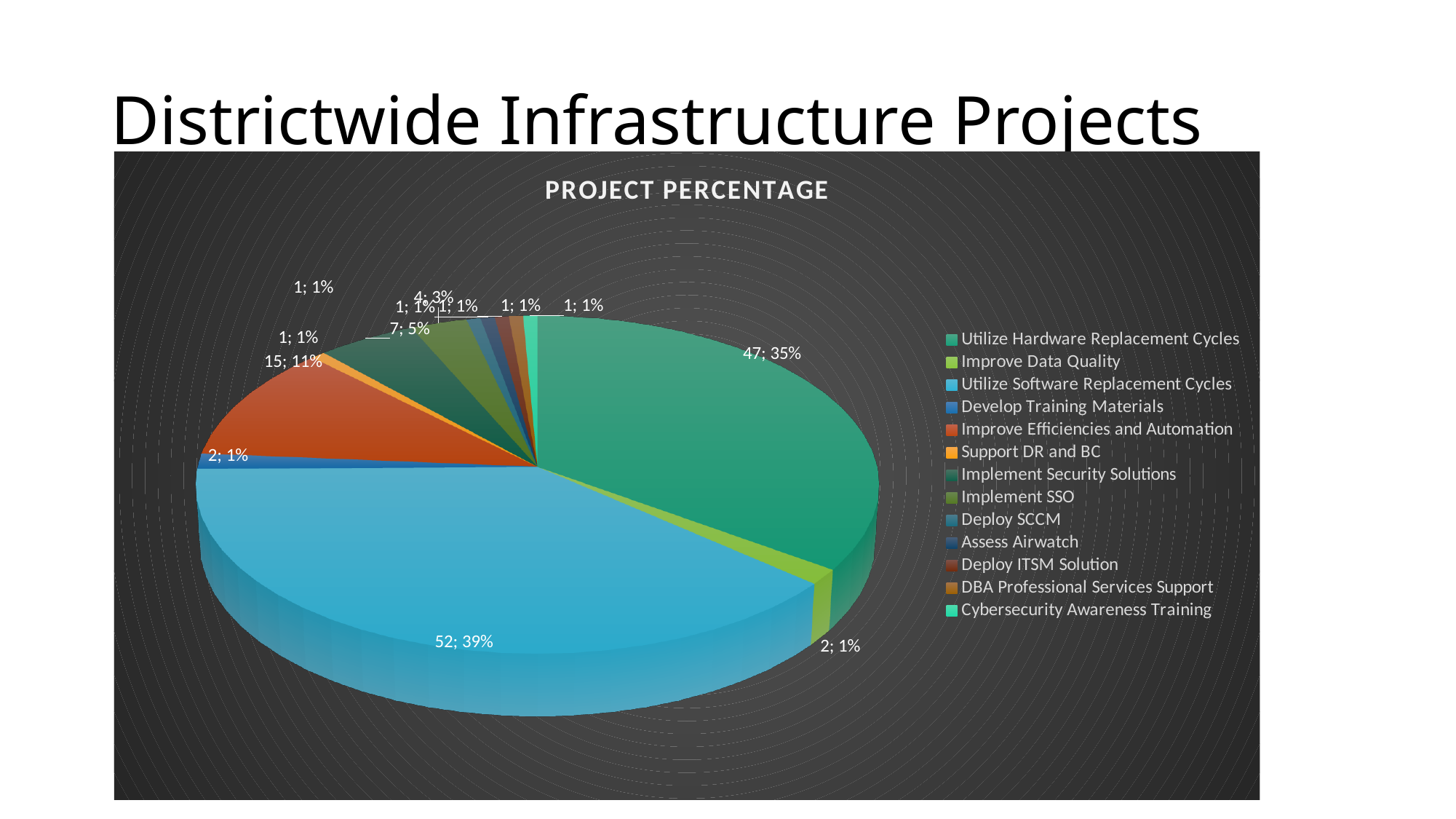
What is the difference between the value for Utilize Software Replacement Cycles and the value for Utilize Hardware Replacement Cycles? 5 How many categories does the legend of the pie chart list? 13 What is the value shown for Improve Efficiencies and Automation? 15 What share of the pie does Improve Efficiencies and Automation represent? 11% What share of the pie does Utilize Software Replacement Cycles represent? 39% Which is larger, the value for Utilize Software Replacement Cycles or the value for Utilize Hardware Replacement Cycles? Utilize Software Replacement Cycles What share of the pie does Utilize Hardware Replacement Cycles represent? 35% What is the value shown for Implement Security Solutions? 7 What is the title of the chart? PROJECT PERCENTAGE Which category has the largest slice of the pie? Utilize Software Replacement Cycles What kind of chart is shown on the slide? pie chart